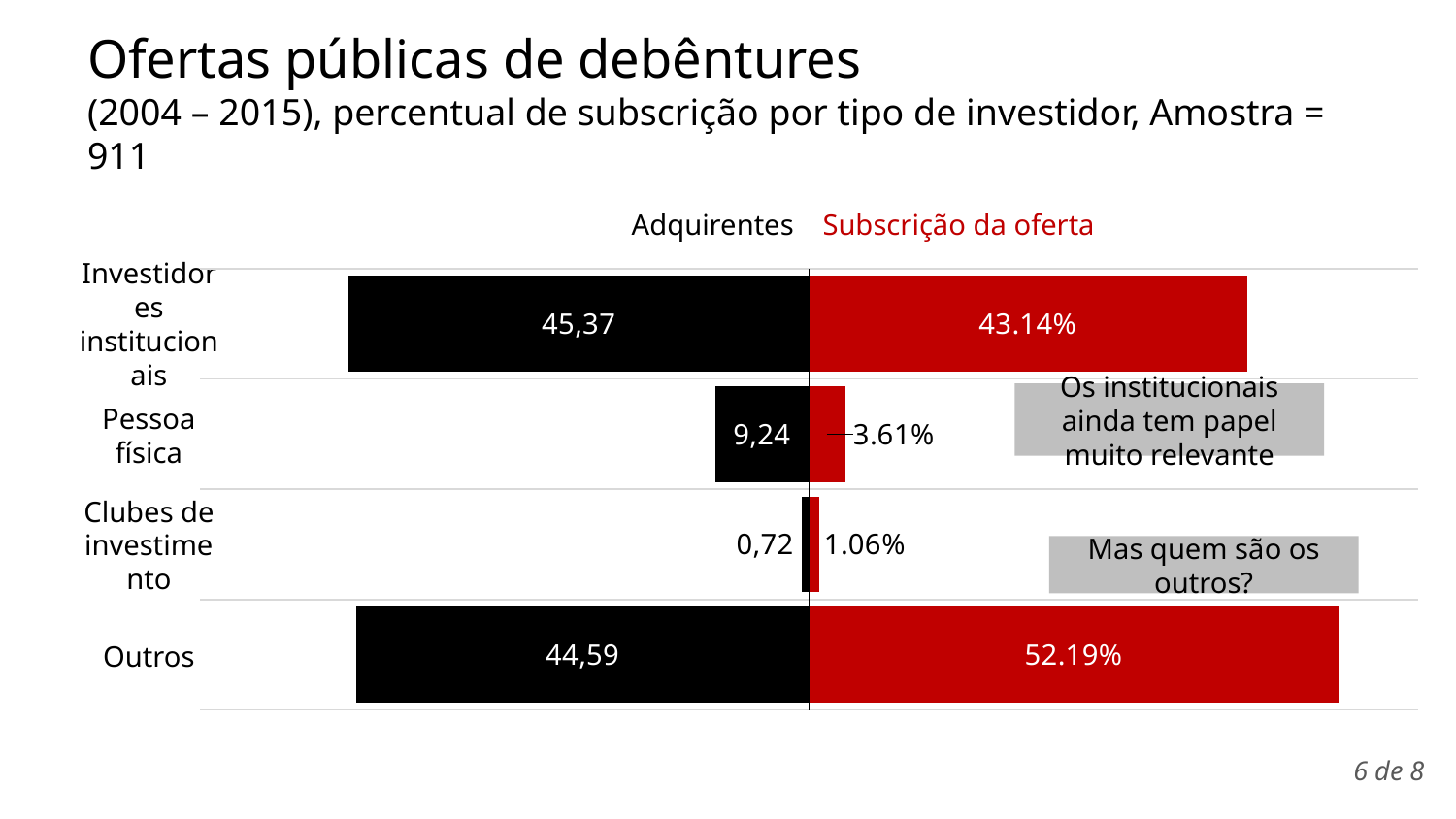
What kind of chart is shown on the slide? Bar chart Which category has the highest Subscrição da oferta value? Outros Which colour represents the Subscrição da oferta series? Red What is the Adquirentes value for Investidores institucionais? 45,37 What is the Subscrição da oferta value for Pessoa física? 3.61% How many categories are shown in the chart? 4 What is the Subscrição da oferta value for Outros? 52.19% Which category has the lowest Adquirentes value? Clubes de investimento What is the difference between the Subscrição da oferta values for Outros and Investidores institucionais? 9.05% What is the Adquirentes value for Clubes de investimento? 0,72 Which is larger, the Adquirentes value for Investidores institucionais or for Outros? Investidores institucionais How many series does the chart show? 2